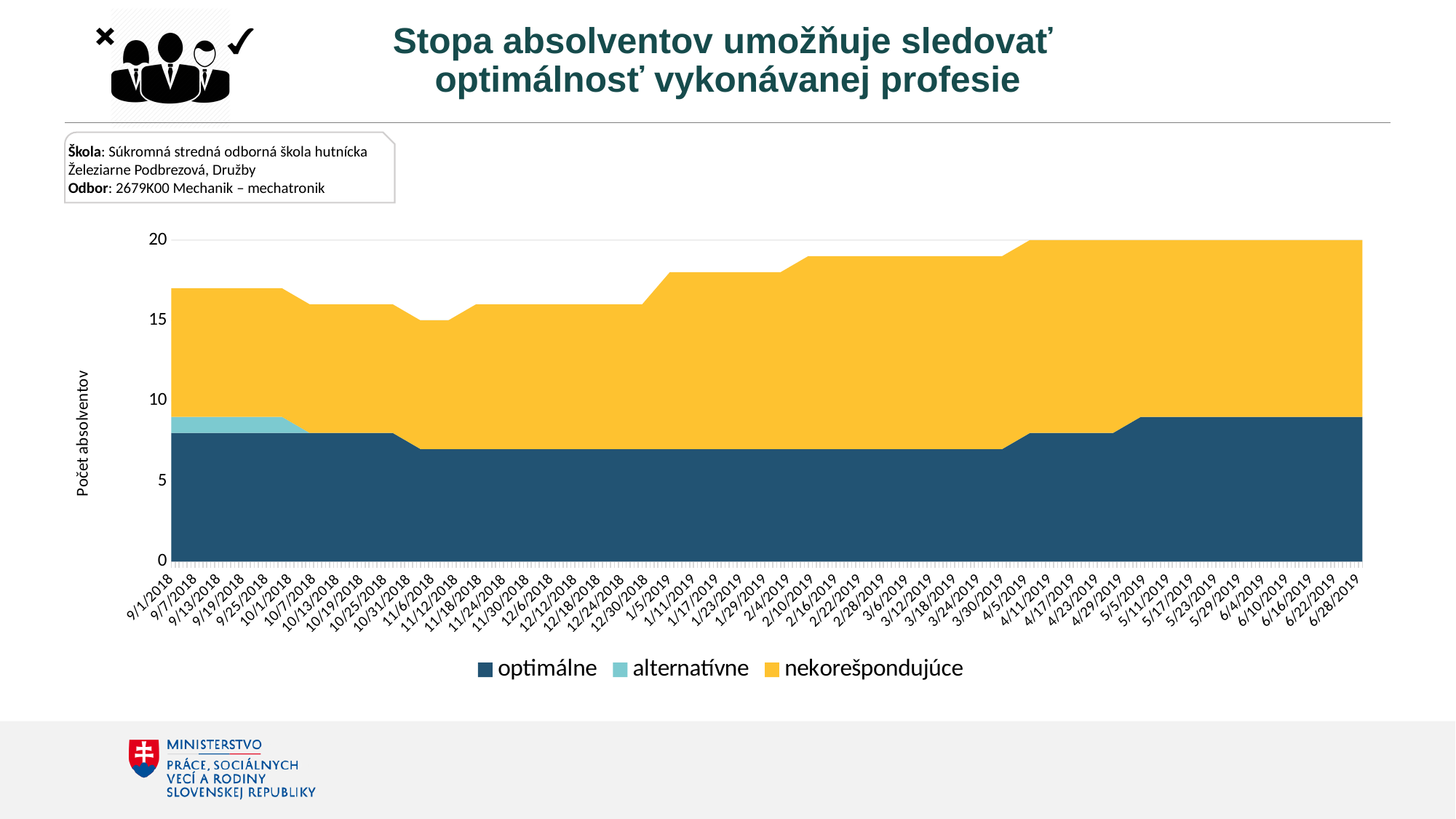
What is the total number of graduates at 6/28/2019? 20 What is the label of the vertical axis of the chart? Počet absolventov Which series has the smallest value at 9/1/2018? alternatívne Is the value for 'optimálne' at 9/1/2018 greater or less than 5? greater Which series has the larger value at 6/28/2019, 'optimálne' or 'nekorešpondujúce'? nekorešpondujúce What kind of chart is shown on the slide? area chart How many series does the chart legend list? 3 Does the total number of graduates rise or fall from 9/1/2018 to 6/28/2019? rise What are the three series named in the chart legend? optimálne, alternatívne, nekorešpondujúce Is the total number of graduates at 9/1/2018 greater or less than 15? greater Is the value for 'optimálne' at 6/28/2019 greater or less than 10? less